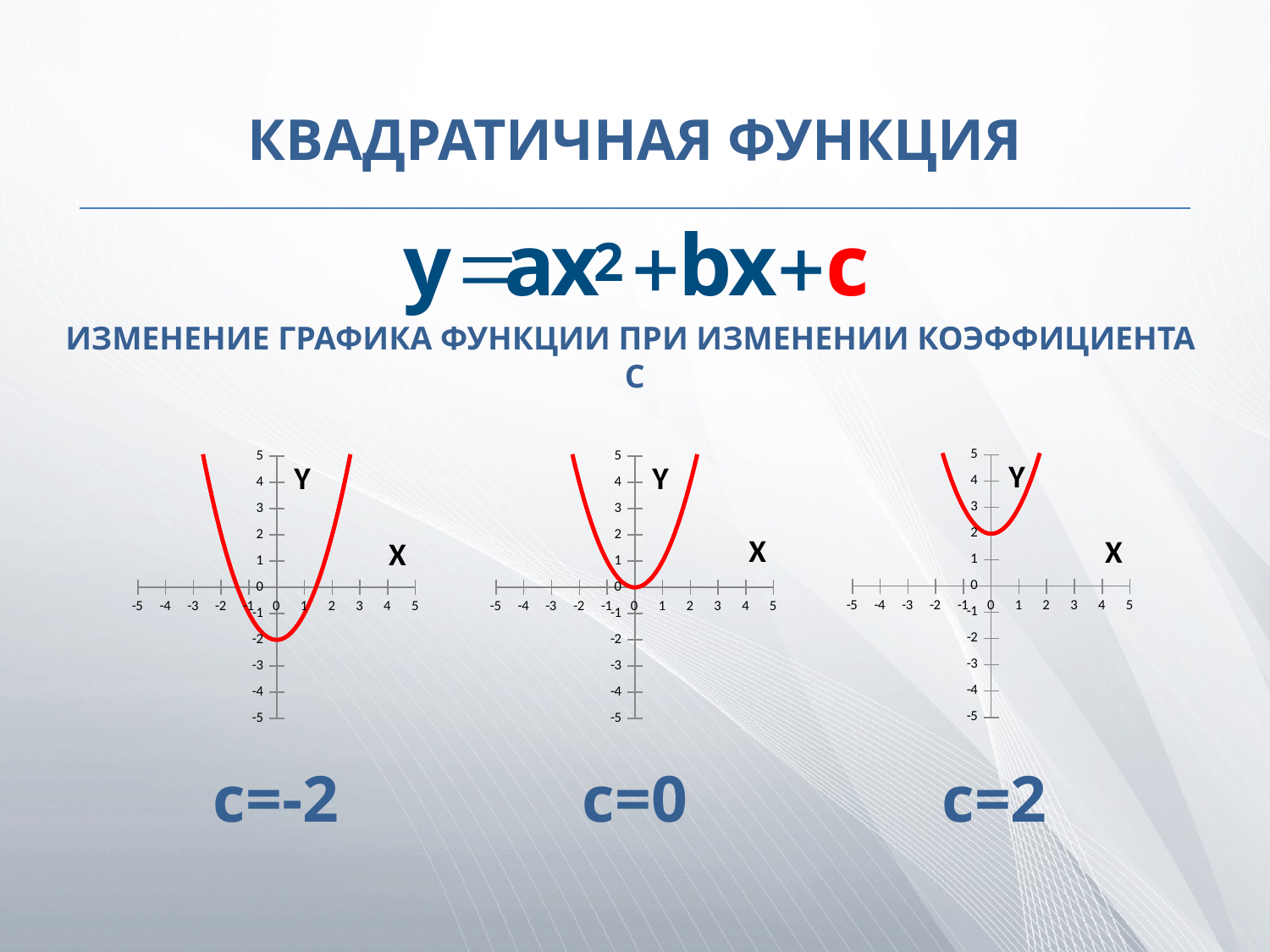
Which of the three charts has the curve with the highest minimum point? c=2 In the chart labelled c=0, what is the y-value of the lowest point of the curve? 0 Is the minimum point of the curve in the c=2 chart greater or less than 0 on the y axis? greater Is the minimum point of the curve in the c=-2 chart greater or less than 0 on the y axis? less In the chart labelled c=0, do the y-values of the curve rise or fall as x increases from 0 to 2? rise Which of the three charts has the curve with the lowest minimum point? c=-2 What is the difference between the minimum y-value of the curve in the c=2 chart and the minimum y-value of the curve in the c=-2 chart? 4 What kind of chart is each of the three graphs on the slide? line chart What is the range of the x axis shown in each of the three charts? -5 to 5 How many charts are shown on the slide? 3 In the chart labelled c=2, what is the y-value of the lowest point of the curve? 2 In the chart labelled c=-2, what is the y-value of the lowest point of the curve? -2